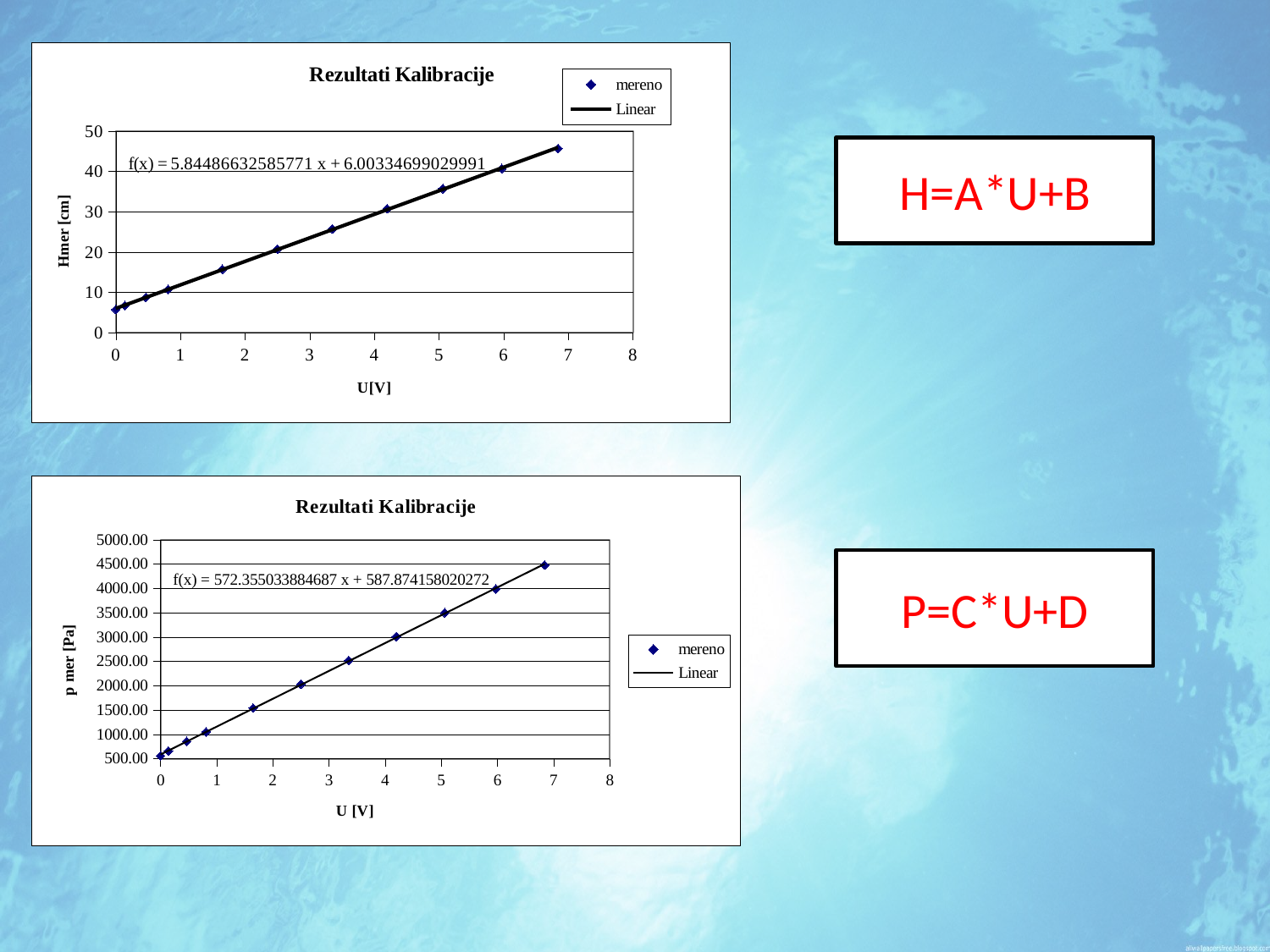
In the top chart, is the Hmer value of the rightmost measured point greater or less than 40? greater In the bottom chart, what is the trendline equation printed on the chart? f(x) = 572.355033884687 x + 587.874158020272 In the top chart, what are the two legend entries? mereno and Linear In the bottom chart, how many series does the legend list? 2 What kind of chart is the top chart titled 'Rezultati Kalibracije'? scatter chart with a linear trendline In the top chart, do the measured values rise or fall as U[V] increases? rise In the top chart, what is the trendline equation printed on the chart? f(x) = 5.84486632585771 x + 6.00334699029991 In the top chart, how many series does the legend list? 2 In the top chart, is the Hmer value of the leftmost measured point (at U = 0) greater or less than 10? less In the bottom chart, is the p mer value of the rightmost measured point greater or less than 4000.00? greater In the bottom chart, do the measured p mer values rise or fall as U [V] increases? rise In the top chart, what is the label of the y axis? Hmer [cm]